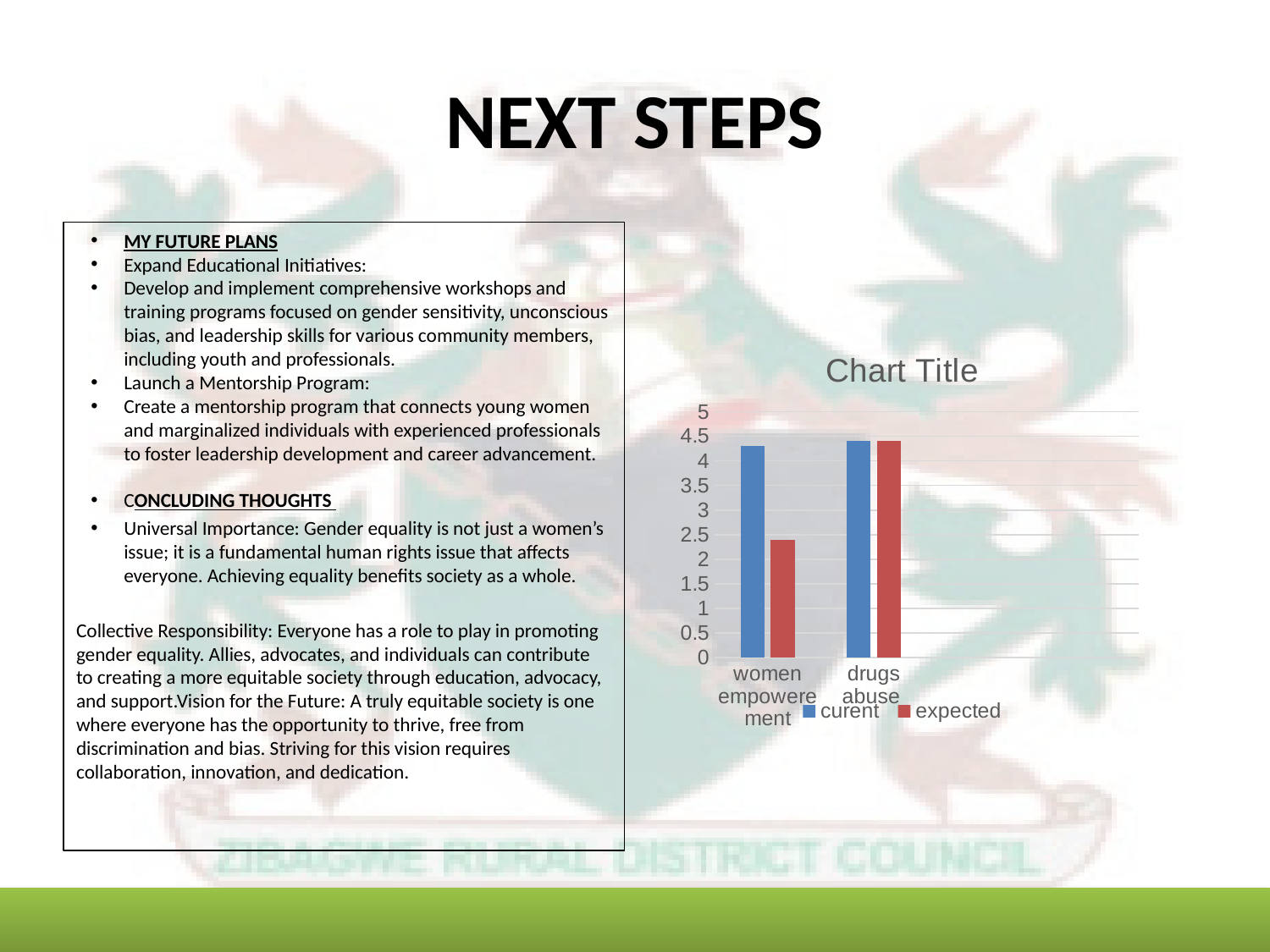
Is the curent value for drugs abuse greater or less than 4? greater What kind of chart is shown on the slide? bar chart How many categories are shown on the x axis of the chart? 2 What is the title of the chart? Chart Title What are the two series names shown in the chart's legend? curent and expected Which bar in the chart is the lowest? expected for women empowerement Is the expected value for women empowerement greater or less than 2? greater Is the expected value for women empowerement greater or less than 3? less For women empowerement, which is larger: the curent value or the expected value? curent How many series does the chart's legend list? 2